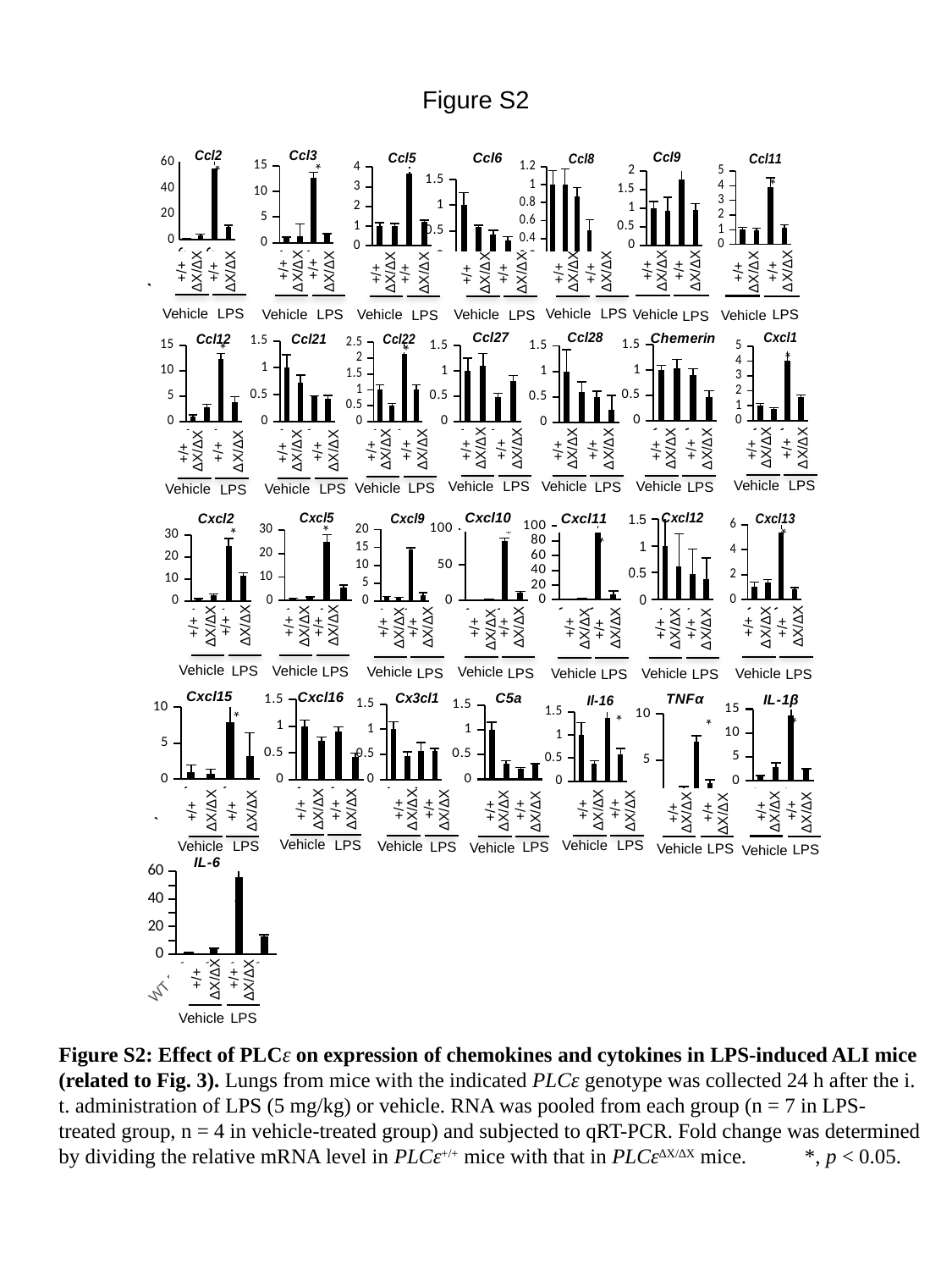
How many bars are plotted in the Ccl2 chart? 4 In the Cxcl5 chart, which bar is the highest? +/+ LPS In the Cxcl2 chart, is the value for the +/+ LPS bar greater or less than 20? greater In the Ccl2 chart, which is larger: the +/+ LPS bar or the ΔX/ΔX LPS bar? +/+ LPS In the Cxcl10 chart, is the value for the +/+ LPS bar greater or less than 50? greater In the Ccl2 chart, is the value for the +/+ LPS bar greater or less than 40? greater What is the title shown at the top of the slide? Figure S2 What kind of chart is used for the Ccl2 panel? bar chart In the IL-6 chart, which bar is the highest? +/+ LPS